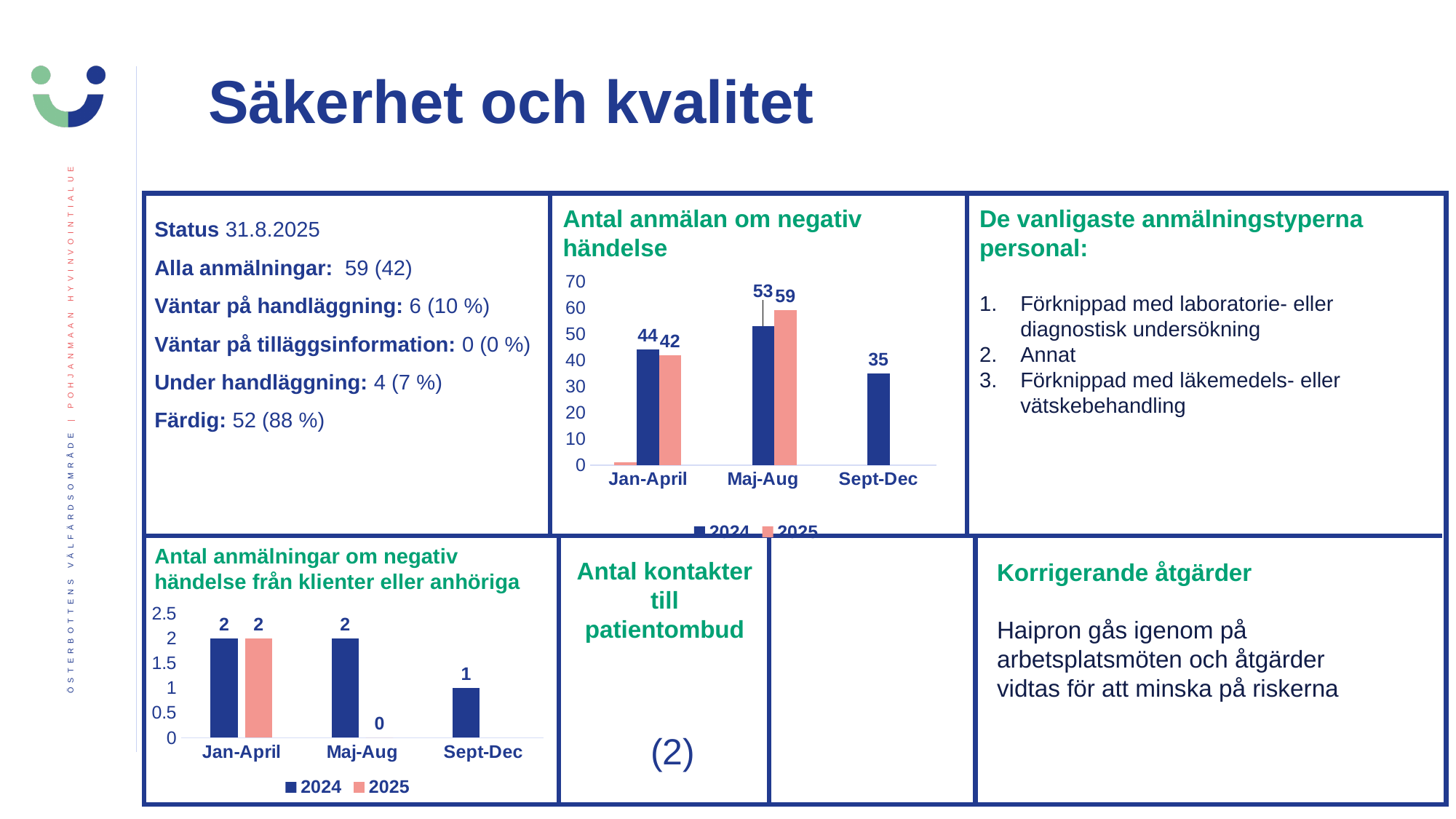
In the chart 'Antal anmälningar om negativ händelse från klienter eller anhöriga', which period has the lowest 2024 value? Sept-Dec In the chart 'Antal anmälan om negativ händelse', what is the value for 2024 in Sept-Dec? 35 In the chart 'Antal anmälan om negativ händelse', what is the value for 2024 in Maj-Aug? 53 What kind of chart is 'Antal anmälan om negativ händelse'? Bar chart In the chart 'Antal anmälningar om negativ händelse från klienter eller anhöriga', how many periods are shown on the x axis? 3 In the chart 'Antal anmälan om negativ händelse', which is larger in Jan-April, the 2024 value or the 2025 value? 2024 In the chart 'Antal anmälan om negativ händelse', how many series does the legend list? 2 In the chart 'Antal anmälningar om negativ händelse från klienter eller anhöriga', what is the value for 2024 in Sept-Dec? 1 In the chart 'Antal anmälningar om negativ händelse från klienter eller anhöriga', what is the value for 2025 in Maj-Aug? 0 In the chart 'Antal anmälan om negativ händelse', what is the value for 2025 in Jan-April? 42 In the chart 'Antal anmälan om negativ händelse', what is the difference between the 2025 and 2024 values in Maj-Aug? 6 In the chart 'Antal anmälan om negativ händelse', which period has the highest 2024 value? Maj-Aug